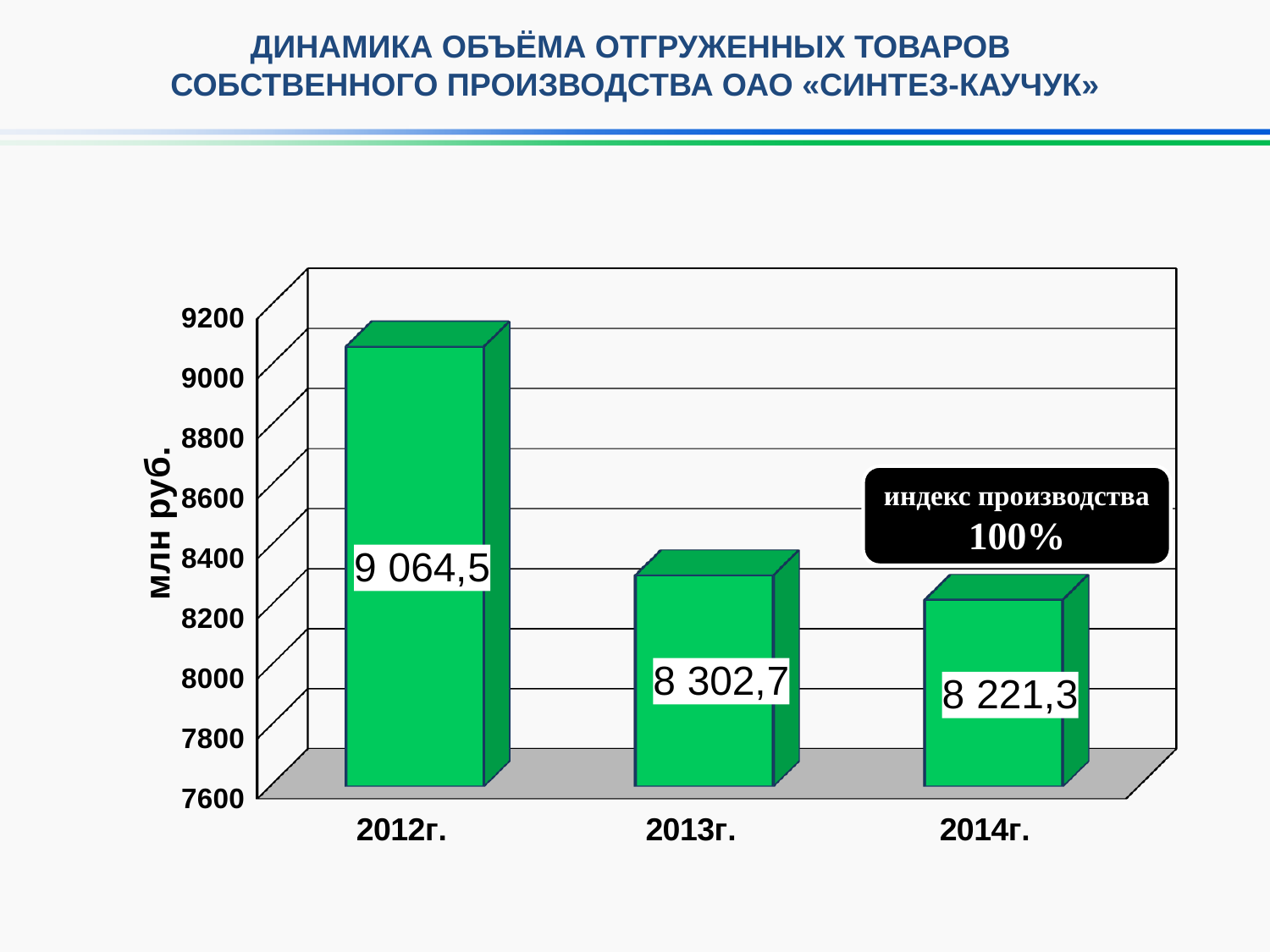
What is the value for 2013г.? 8 302,7 What is the value for 2014г.? 8 221,3 What is the difference between the values for 2013г. and 2014г.? 81,4 Which is larger, the value for 2012г. or the value for 2014г.? 2012г. How many years are shown on the x axis? 3 Is the value for 2013г. greater or less than 8400? less What is the label of the vertical axis? млн руб. What is the difference between the values for 2012г. and 2013г.? 761,8 Which year has the highest value? 2012г. Which year has the lowest value? 2014г. What kind of chart is shown on the slide? bar chart What is the value for 2012г.? 9 064,5